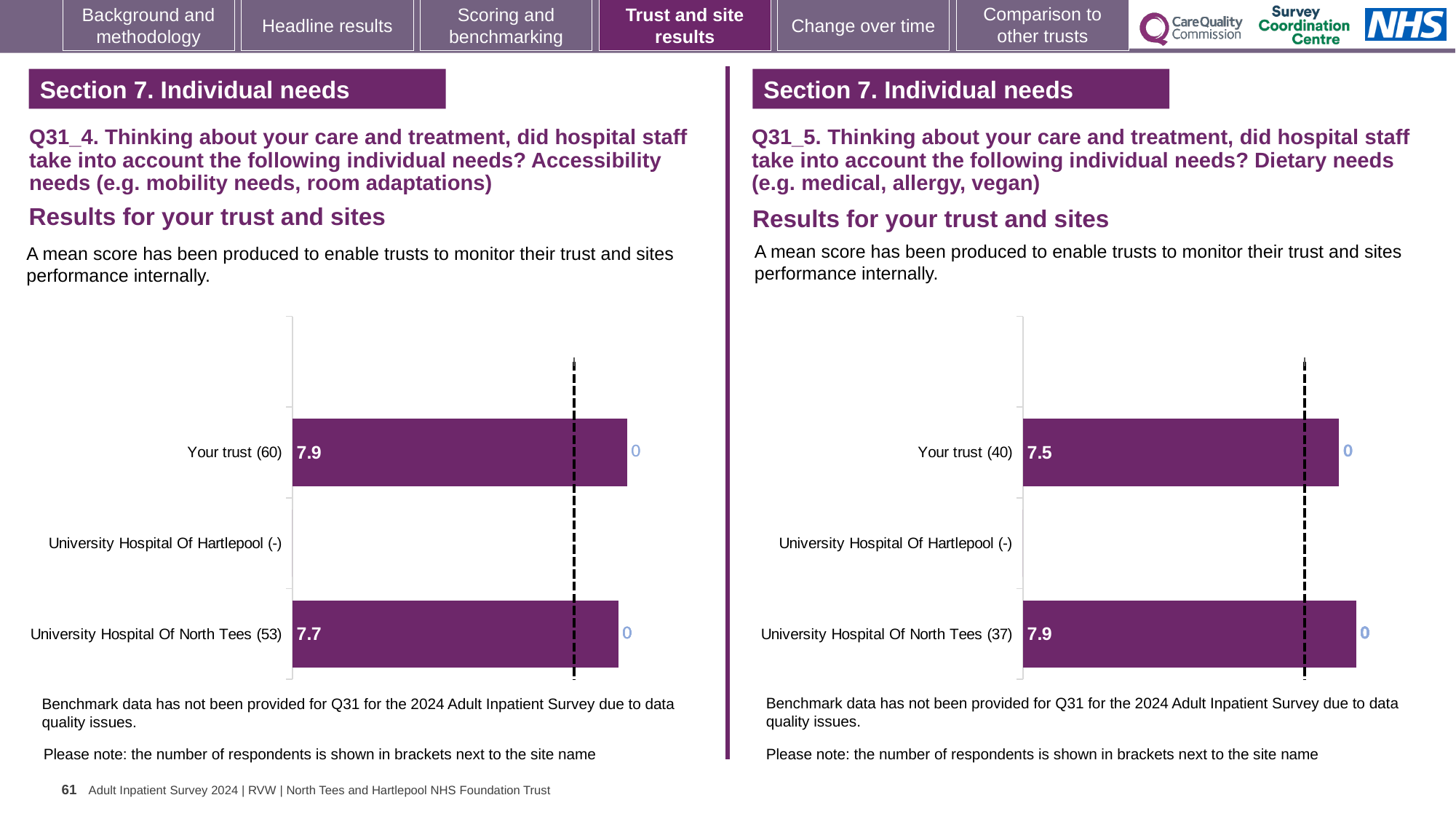
On the left chart (Q31_4, accessibility needs), what is the mean score for University Hospital Of North Tees? 7.7 On the left chart (Q31_4, accessibility needs), how many respondents are shown in brackets for Your trust? 60 On the left chart (Q31_4, accessibility needs), what is the difference between the scores for Your trust and University Hospital Of North Tees? 0.2 On the right chart (Q31_5, dietary needs), what is the difference between the scores for University Hospital Of North Tees and Your trust? 0.4 On the left chart (Q31_4, accessibility needs), which has the higher score: Your trust or University Hospital Of North Tees? Your trust What type of chart is used on the left side of the slide for Q31_4? Bar chart On the right chart (Q31_5, dietary needs), what is the mean score for Your trust? 7.5 On the right chart (Q31_5, dietary needs), what is the mean score for University Hospital Of North Tees? 7.9 How many categories are listed on the vertical axis of the right chart (Q31_5, dietary needs)? 3 On the right chart (Q31_5, dietary needs), how many respondents are shown in brackets for University Hospital Of North Tees? 37 On the left chart (Q31_4, accessibility needs), what is the mean score for Your trust? 7.9 On the right chart (Q31_5, dietary needs), which has the higher score: Your trust or University Hospital Of North Tees? University Hospital Of North Tees